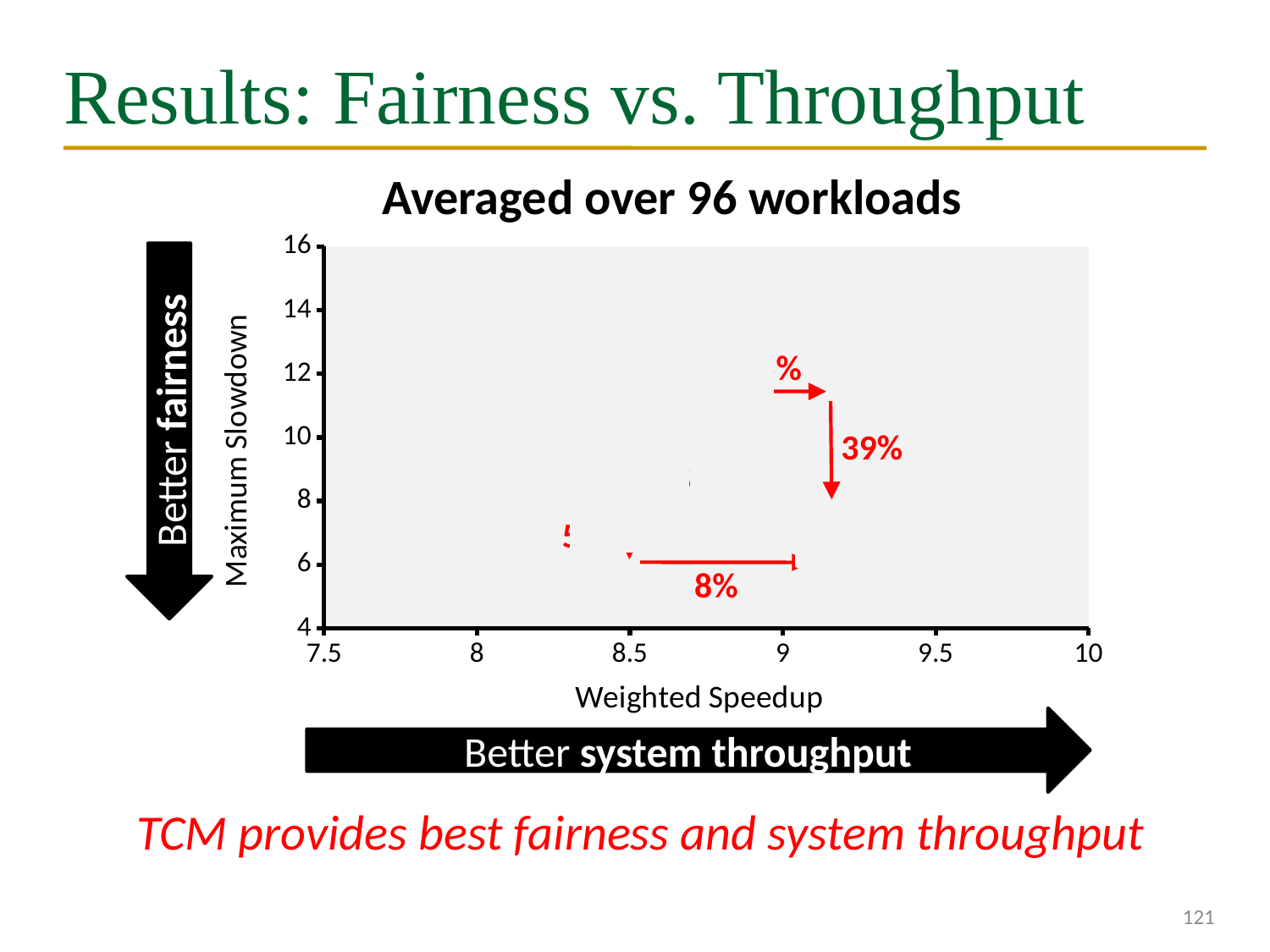
What is the label of the x axis of the chart? Weighted Speedup What percentage is printed below the horizontal red arrow near the bottom of the chart? 8% What percentage is printed next to the vertical red arrow in the chart? 39% What is the title of the chart? Averaged over 96 workloads What kind of chart is shown on the slide? scatter chart